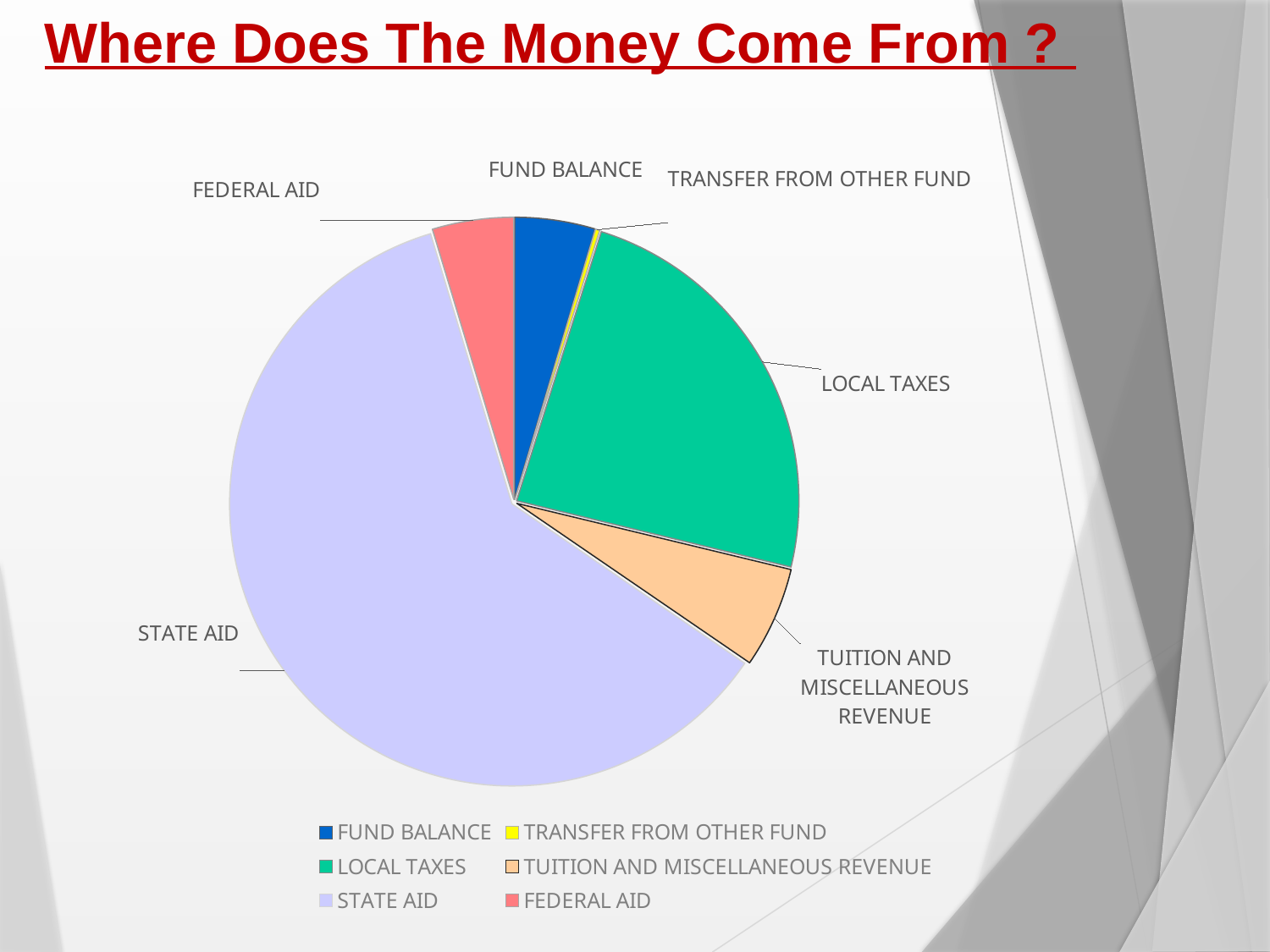
Which is larger, the slice for STATE AID or the slice for LOCAL TAXES? STATE AID Which is larger, the slice for LOCAL TAXES or the slice for FEDERAL AID? LOCAL TAXES How many slices does the pie chart have? 6 Which is larger, the slice for FUND BALANCE or the slice for TRANSFER FROM OTHER FUND? FUND BALANCE Which category is the second-largest slice of the pie? LOCAL TAXES What colour is the LOCAL TAXES slice in the pie chart? green What kind of chart is shown on the slide? pie chart Which category has the smallest slice of the pie? TRANSFER FROM OTHER FUND Which category has the largest slice of the pie? STATE AID What is the title of the slide containing the pie chart? Where Does The Money Come From ? How many entries does the legend list? 6